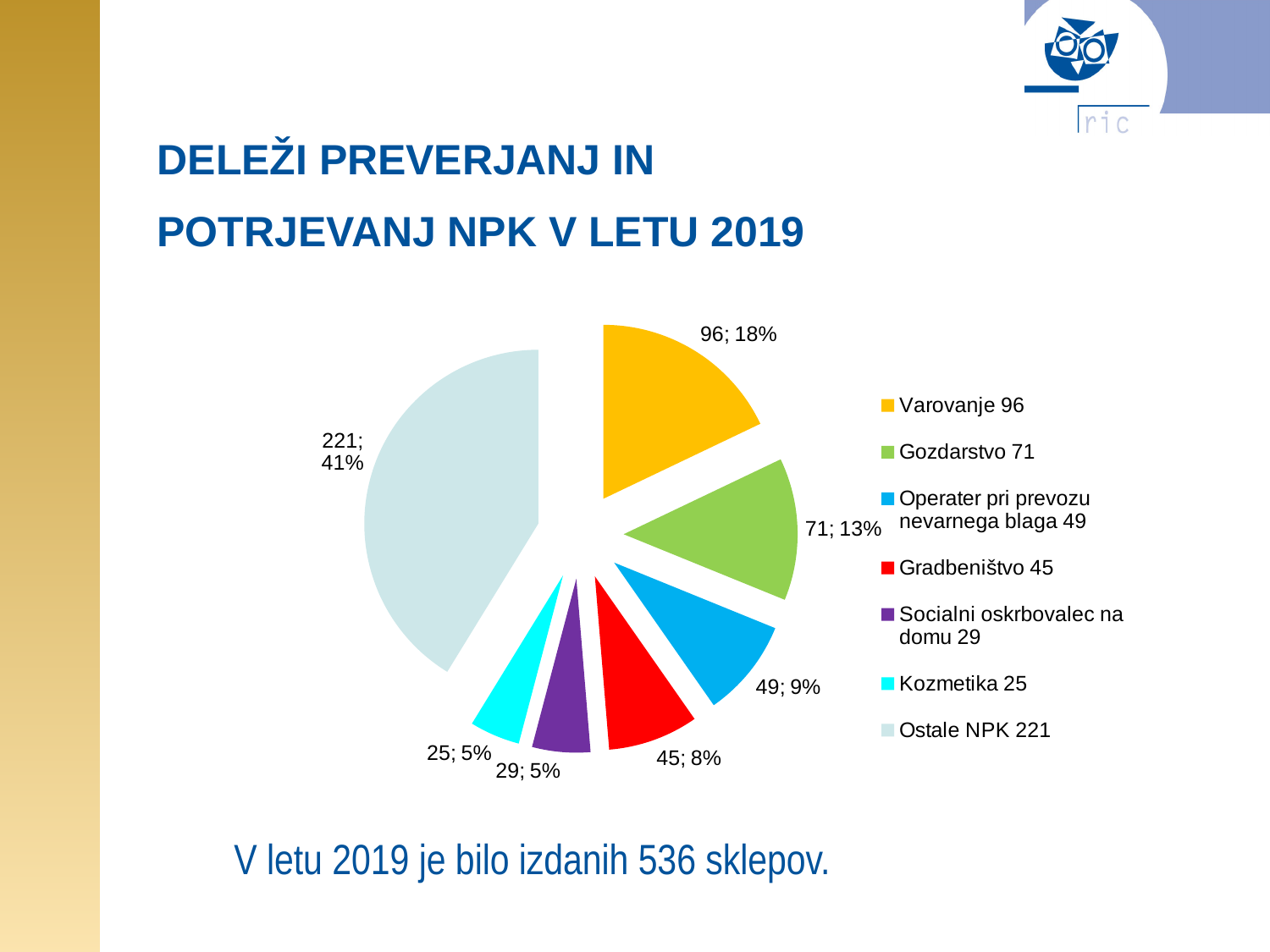
What is the difference between the values for Varovanje and Gozdarstvo? 25 What value is shown for Varovanje? 96 What percentage share does Gradbeništvo have? 8% Which category has the smallest slice? Kozmetika How many slices does the pie chart have? 7 Which category has the largest slice? Ostale NPK Which is larger, the value for Gradbeništvo or the value for Socialni oskrbovalec na domu? Gradbeništvo What kind of chart is shown on the slide? pie chart What percentage share does Ostale NPK have? 41% What value is shown for Operater pri prevozu nevarnega blaga? 49 What percentage share does Gozdarstvo have? 13% What colour is the Kozmetika slice? cyan